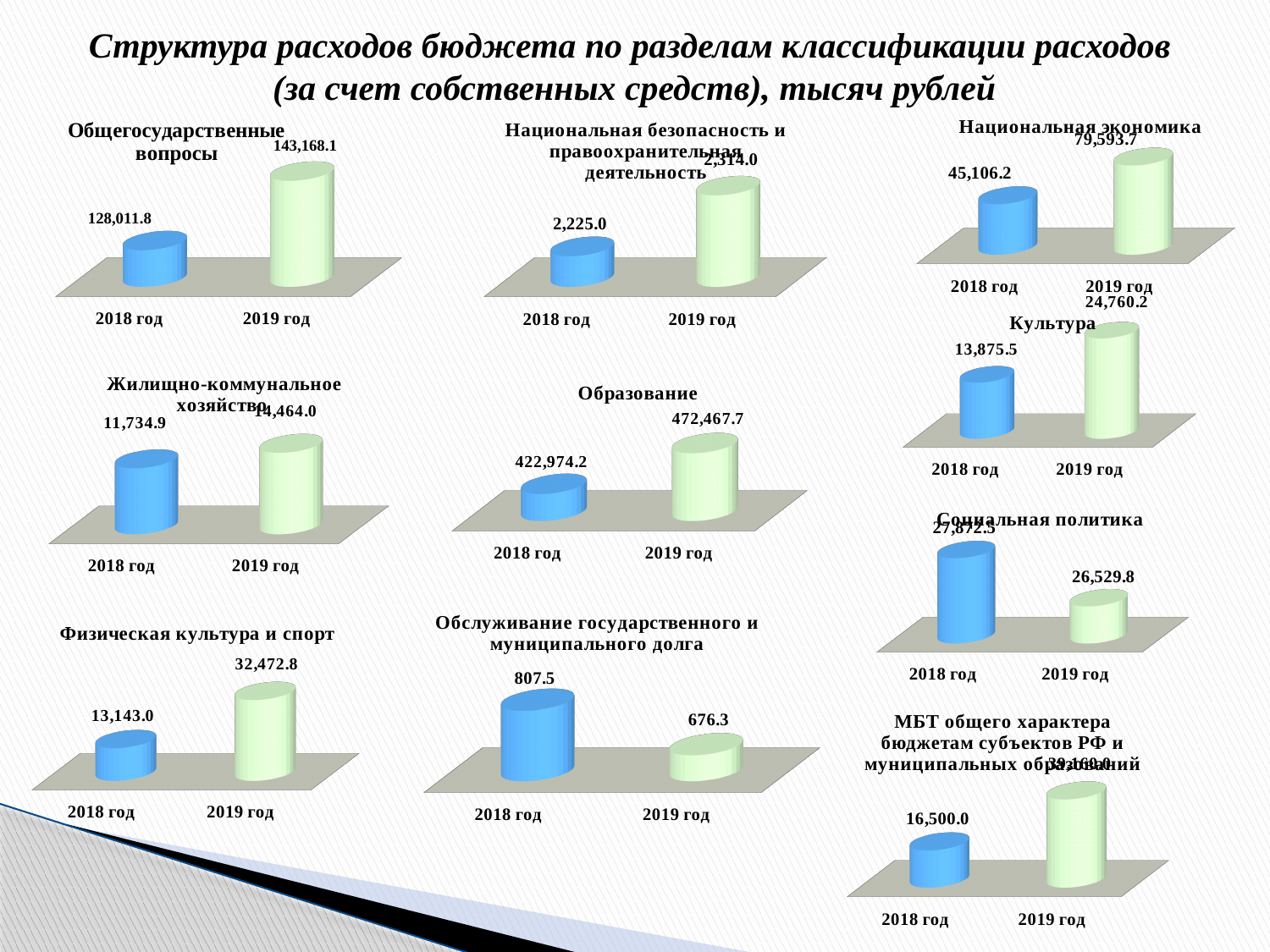
In the 'Образование' chart, which year has the higher value? 2019 год In the 'Общегосударственные вопросы' chart, what is the value for 2019 год? 143,168.1 In the 'Социальная политика' chart, what is the value for 2019 год? 26,529.8 In the 'Национальная экономика' chart, what is the difference between the 2019 год and 2018 год values? 34,487.5 In the 'Культура' chart, what is the value for 2018 год? 13,875.5 In the 'Обслуживание государственного и муниципального долга' chart, what is the difference between the 2018 год and 2019 год values? 131.2 In the 'Обслуживание государственного и муниципального долга' chart, which year has the lower value? 2019 год In the 'Общегосударственные вопросы' chart, what is the value for 2018 год? 128,011.8 In the 'Национальная экономика' chart, what is the value for 2018 год? 45,106.2 In the 'Образование' chart, what is the value for 2019 год? 472,467.7 How many categories are shown on the x axis of the 'Национальная безопасность и правоохранительная деятельность' chart? 2 In the 'Физическая культура и спорт' chart, what is the value for 2019 год? 32,472.8